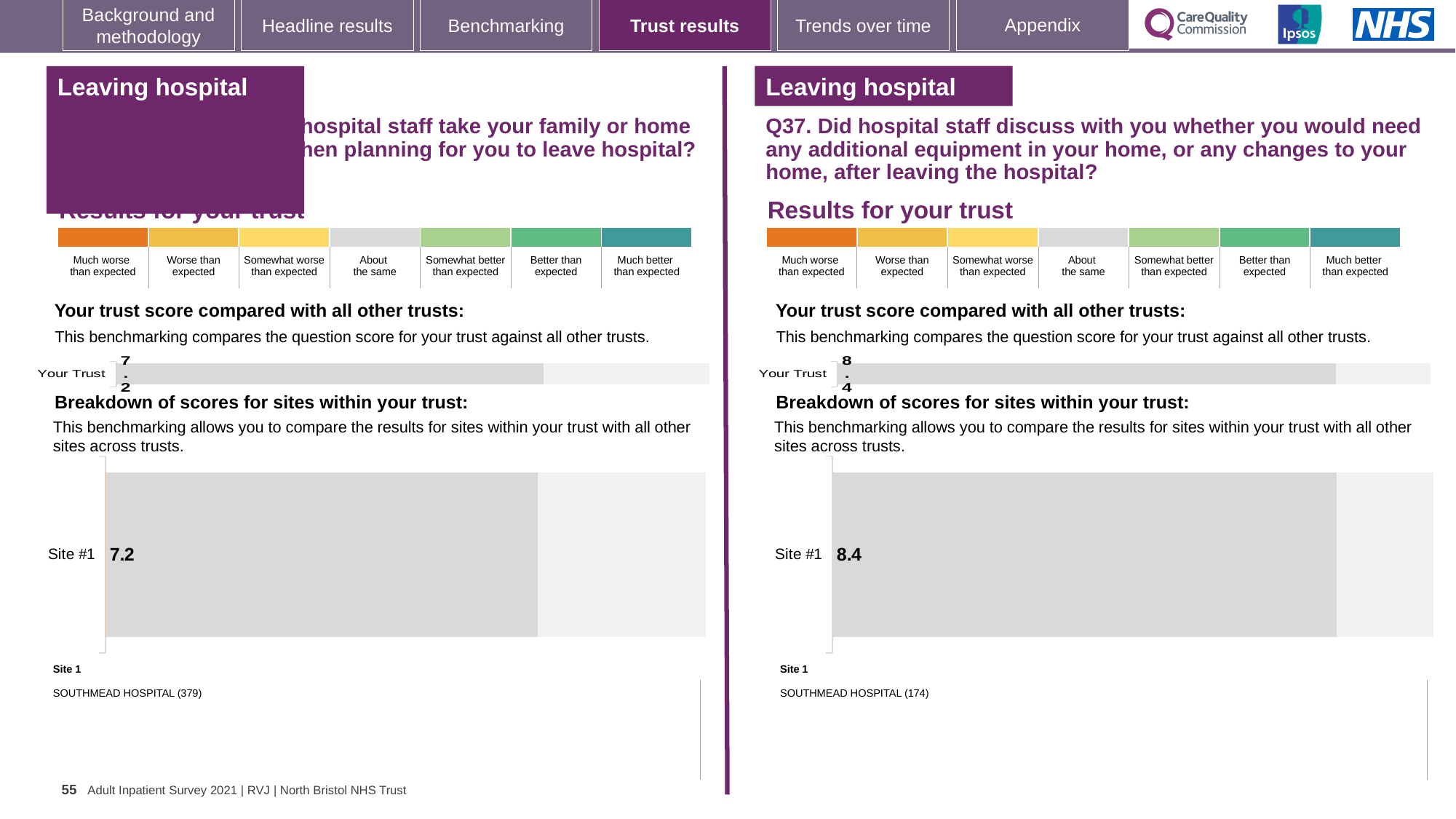
On the left-hand side, what number appears in parentheses after SOUTHMEAD HOSPITAL? 379 On the right-hand side, which hospital is listed as Site 1? SOUTHMEAD HOSPITAL How many sites are shown in the right-hand site breakdown chart? 1 How many categories are shown in the colour scale under 'Results for your trust' on the right-hand side? 7 Which has the higher Site #1 score: the left-hand chart or the right-hand chart (Q37)? the right-hand chart (Q37) On the left-hand chart, what is the score shown for Your Trust? 7.2 On the right-hand chart (Q37), what is the score shown for Your Trust? 8.4 On the right-hand site breakdown chart (Q37), what is the score for Site #1? 8.4 On the left-hand site breakdown chart, what is the score for Site #1? 7.2 What kind of chart is used to show the Site #1 score on the right-hand side? bar chart What is the difference between the Site #1 score on the right-hand chart (Q37) and the Site #1 score on the left-hand chart? 1.2